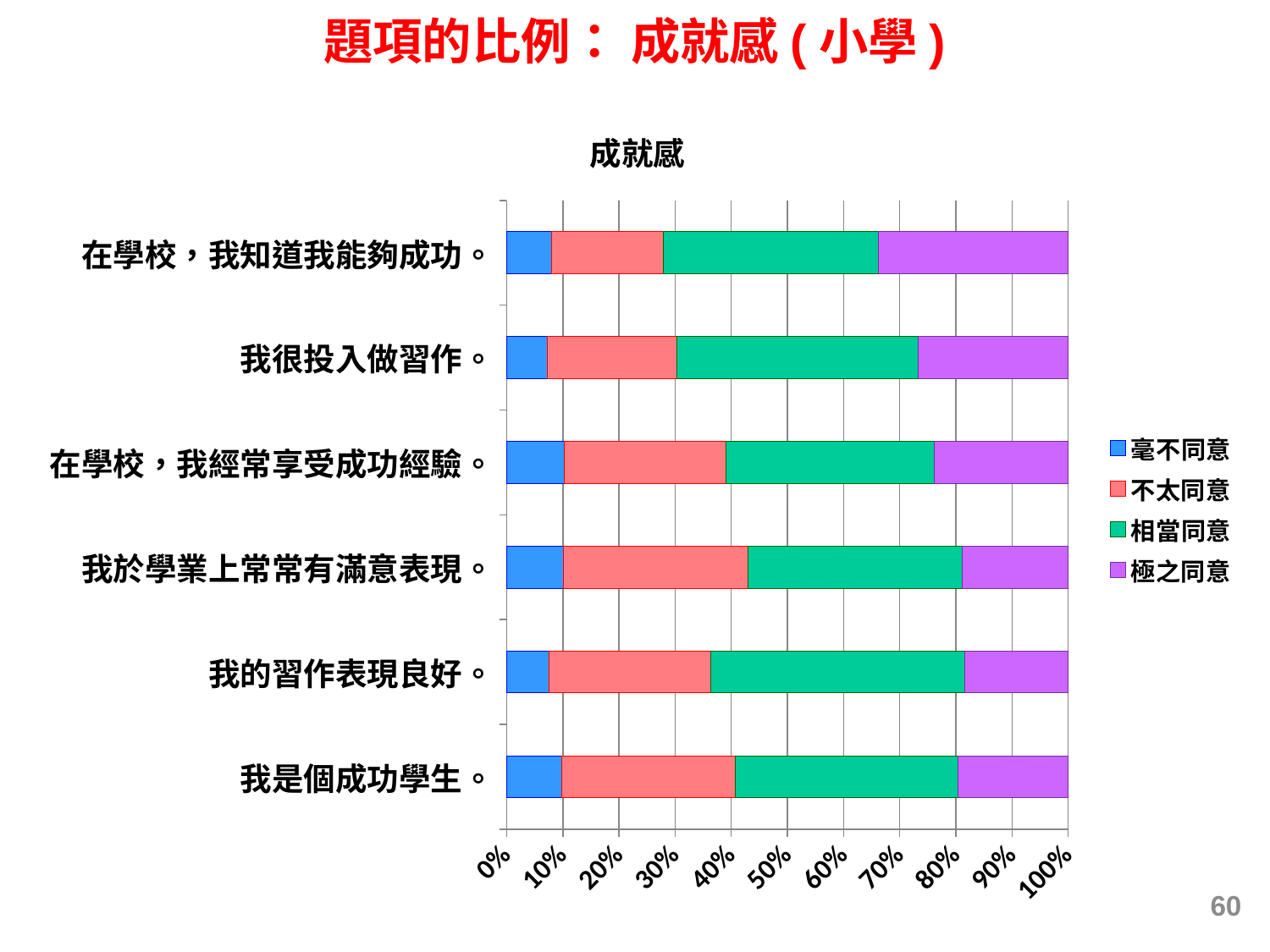
Which legend entry is shown in purple? 極之同意 Is the 極之同意 share for 「我於學業上常常有滿意表現。」 greater or less than 30%? less Which has the larger 極之同意 share: 「在學校，我知道我能夠成功。」 or 「我很投入做習作。」? 在學校，我知道我能夠成功。 How many statements (categories) are plotted on the chart? 6 Which has the larger 不太同意 share: 「我於學業上常常有滿意表現。」 or 「在學校，我知道我能夠成功。」? 我於學業上常常有滿意表現。 What is the title of the chart? 成就感 Is the 毫不同意 share for 「我很投入做習作。」 greater or less than 10%? less Is the 不太同意 share for 「我於學業上常常有滿意表現。」 greater or less than 20%? greater How many series does the legend list? 4 What kind of chart is shown on the slide? Stacked bar chart Which statement has the largest 極之同意 share? 在學校，我知道我能夠成功。